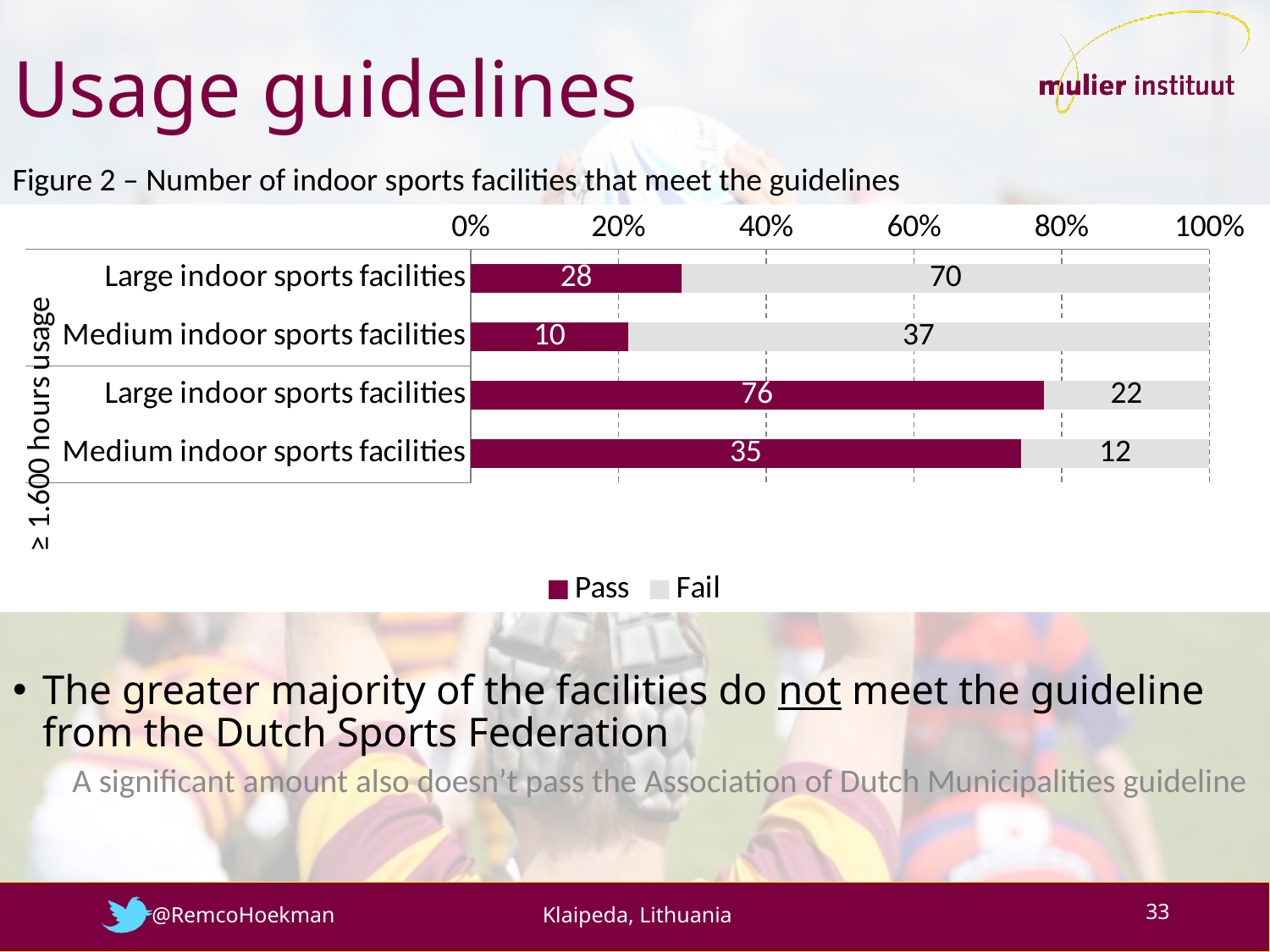
Which bar has the highest Pass value? Large indoor sports facilities (≥ 1.600 hours usage), 76 What kind of chart is shown in Figure 2? Stacked bar chart What is the Fail value for the second bar from the top (Medium indoor sports facilities)? 37 What is the total (Pass plus Fail) for Medium indoor sports facilities in the ≥ 1.600 hours usage group? 47 What is the Fail value for Medium indoor sports facilities in the ≥ 1.600 hours usage group? 12 What is the Pass value for Large indoor sports facilities in the ≥ 1.600 hours usage group? 76 What is the total (Pass plus Fail) for the topmost bar, Large indoor sports facilities? 98 For the topmost bar (Large indoor sports facilities), how much larger is the Fail value than the Pass value? 42 How many series does the legend of the chart list? 2 What are the two legend entries in the chart? Pass and Fail How many bars are plotted in the chart? 4 What is the Pass value for the topmost bar (Large indoor sports facilities)? 28